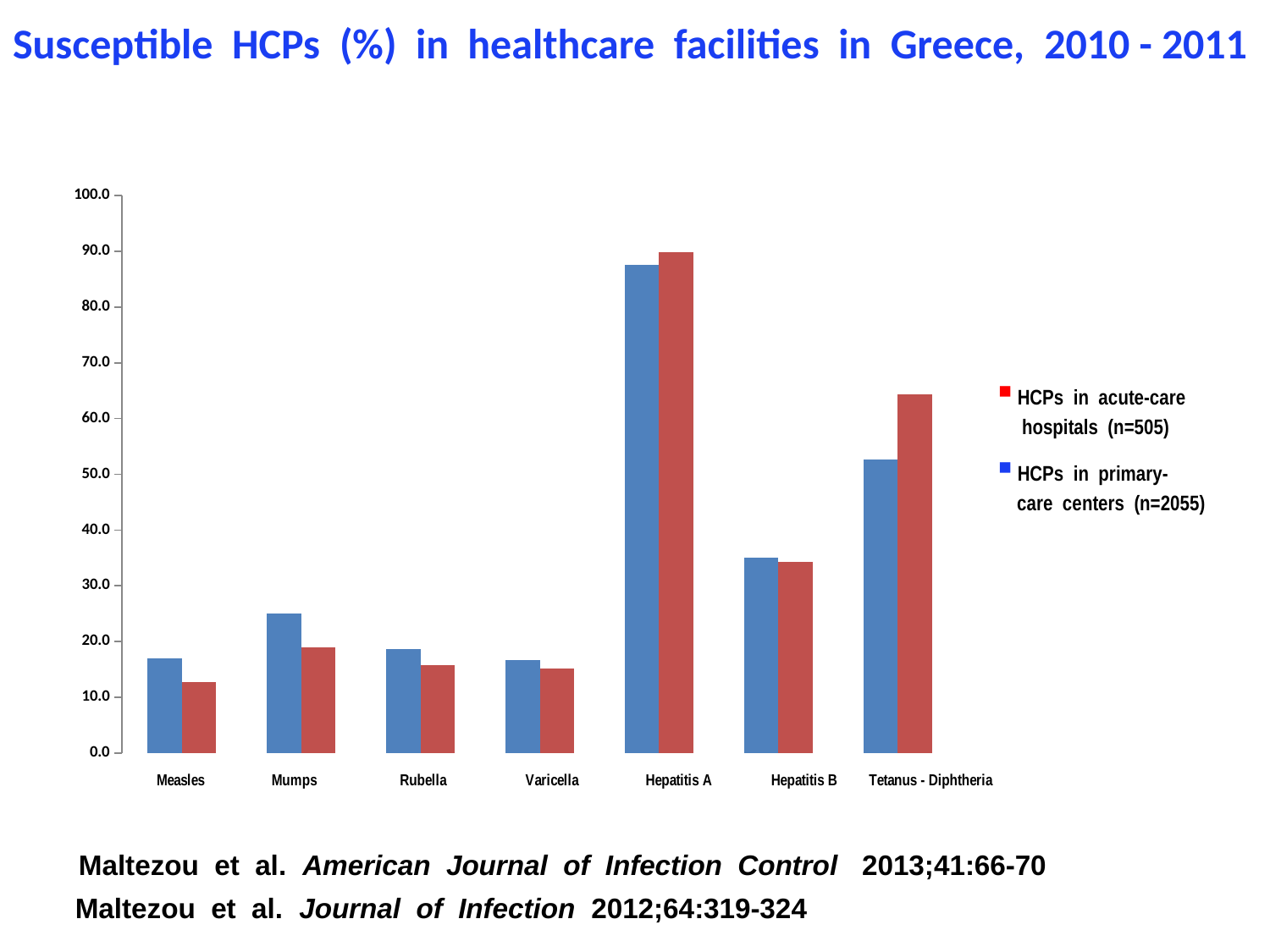
How many series does the legend list? 2 Is the value for Hepatitis B among HCPs in acute-care hospitals greater or less than 40? less What kind of chart is shown on the slide? bar chart For HCPs in primary-care centers, which disease has the highest percentage of susceptible HCPs? Hepatitis A What colour represents HCPs in acute-care hospitals in the chart? red For HCPs in acute-care hospitals, which disease has the highest percentage of susceptible HCPs? Hepatitis A For Tetanus - Diphtheria, which group has the larger percentage of susceptible HCPs: acute-care hospitals or primary-care centers? acute-care hospitals Is the value for Hepatitis A among HCPs in primary-care centers greater or less than 80? greater How many disease categories are shown on the x axis? 7 Is the value for Tetanus - Diphtheria among HCPs in primary-care centers greater or less than 60? less For HCPs in acute-care hospitals, which disease has the lowest percentage of susceptible HCPs? Measles For Mumps, which group has the larger percentage of susceptible HCPs: acute-care hospitals or primary-care centers? primary-care centers